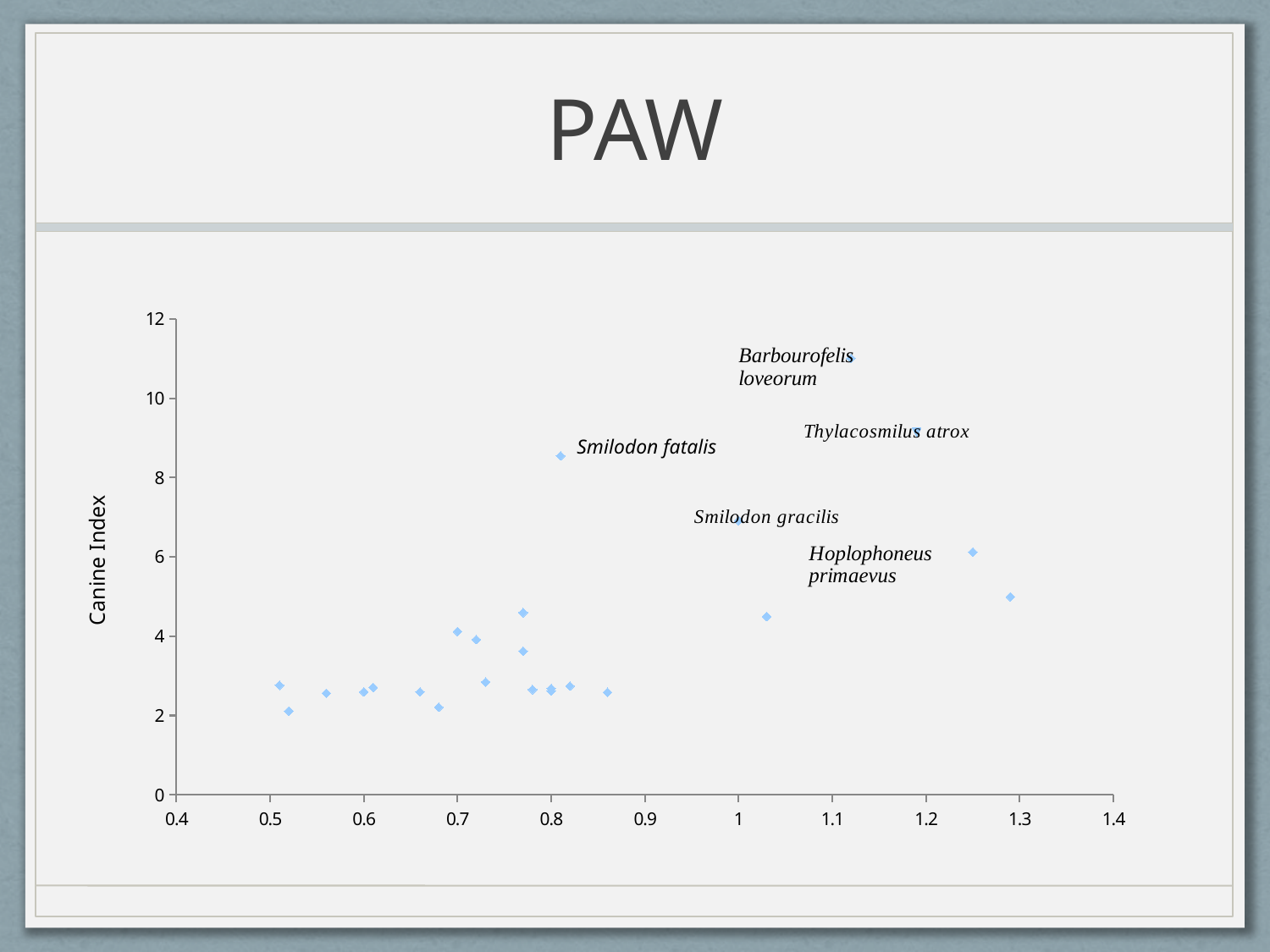
What kind of chart is shown on the slide? scatter chart Which has the higher Canine Index, Thylacosmilus atrox or Hoplophoneus primaevus? Thylacosmilus atrox What is the title of the chart's vertical axis? Canine Index Is the Canine Index for Thylacosmilus atrox greater or less than 10? less Is the Canine Index for Barbourofelis loveorum greater or less than 10? greater Which has the higher Canine Index, Smilodon fatalis or Smilodon gracilis? Smilodon fatalis Is the Canine Index for Smilodon fatalis greater or less than 8? greater Among the labeled species, which has the lowest Canine Index? Hoplophoneus primaevus What is the title of the chart? PAW Among the labeled species, which has the highest Canine Index? Barbourofelis loveorum